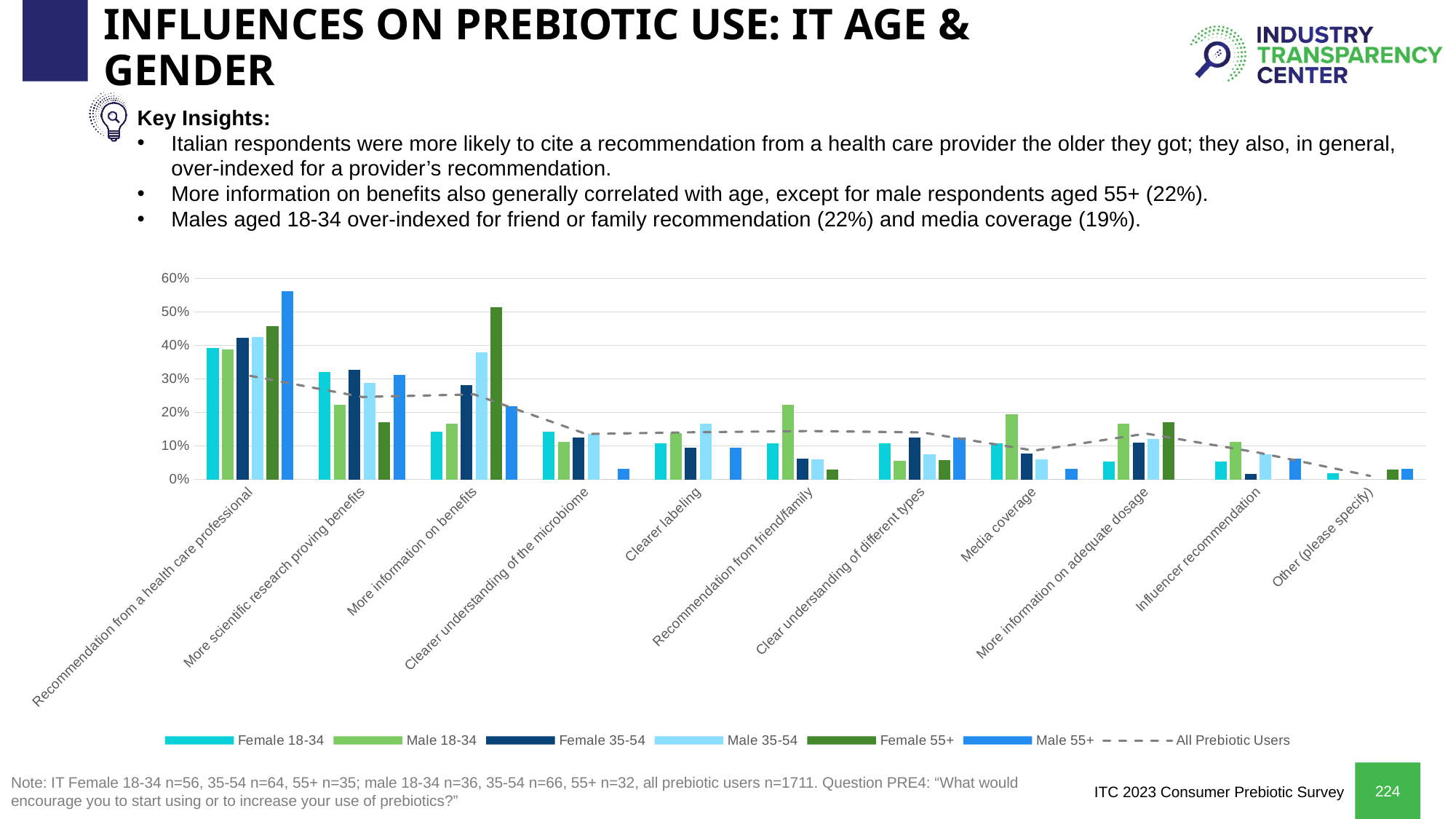
Is the value for Female 55+ under "More scientific research proving benefits" greater or less than 20%? less Which series has the highest bar for "Recommendation from a health care professional"? Male 55+ What kind of chart is shown on the slide? combination bar and line chart What does the dashed grey line in the chart represent? All Prebiotic Users Is the value for Female 55+ under "More information on benefits" greater or less than 40%? greater How many entries does the chart legend list? 7 Is the value for Male 18-34 under "Media coverage" greater or less than 10%? greater Which category has the lowest bars overall in the chart? Other (please specify) For "Recommendation from friend/family", which is larger: Male 18-34 or Female 18-34? Male 18-34 How many categories are shown along the x axis of the chart? 11 Which category contains the tallest bar in the chart? Recommendation from a health care professional